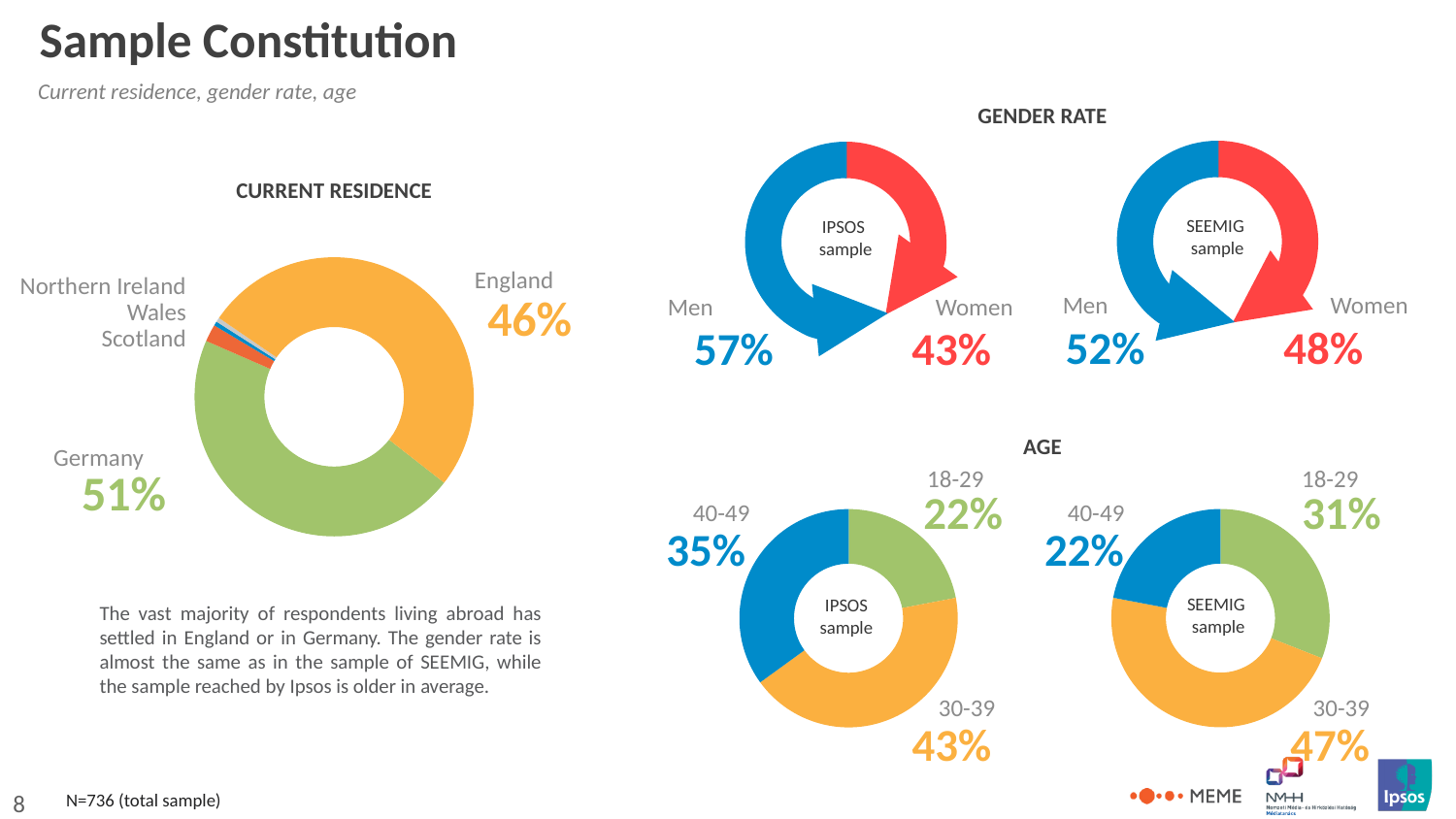
In the Current Residence chart, what is the difference between the Germany and England shares? 5% In the Gender Rate chart for the IPSOS sample, what is the share of men? 57% In the Gender Rate charts, which sample has the higher share of men, IPSOS or SEEMIG? IPSOS In the Gender Rate chart for the SEEMIG sample, what is the share of women? 48% What type of chart is used for the Current Residence data? Donut (pie) chart How many age groups are shown in the Age chart for the SEEMIG sample? 3 In the Current Residence chart, what share of respondents live in Germany? 51% In the Current Residence chart, which country has the largest share? Germany In the Age chart for the IPSOS sample, what is the share of the 30-39 age group? 43% In the Current Residence chart, what share of respondents live in England? 46% In the Age chart for the SEEMIG sample, which age group has the smallest share? 40-49 In the Age chart for the IPSOS sample, what is the difference between the 40-49 and 18-29 shares? 13%